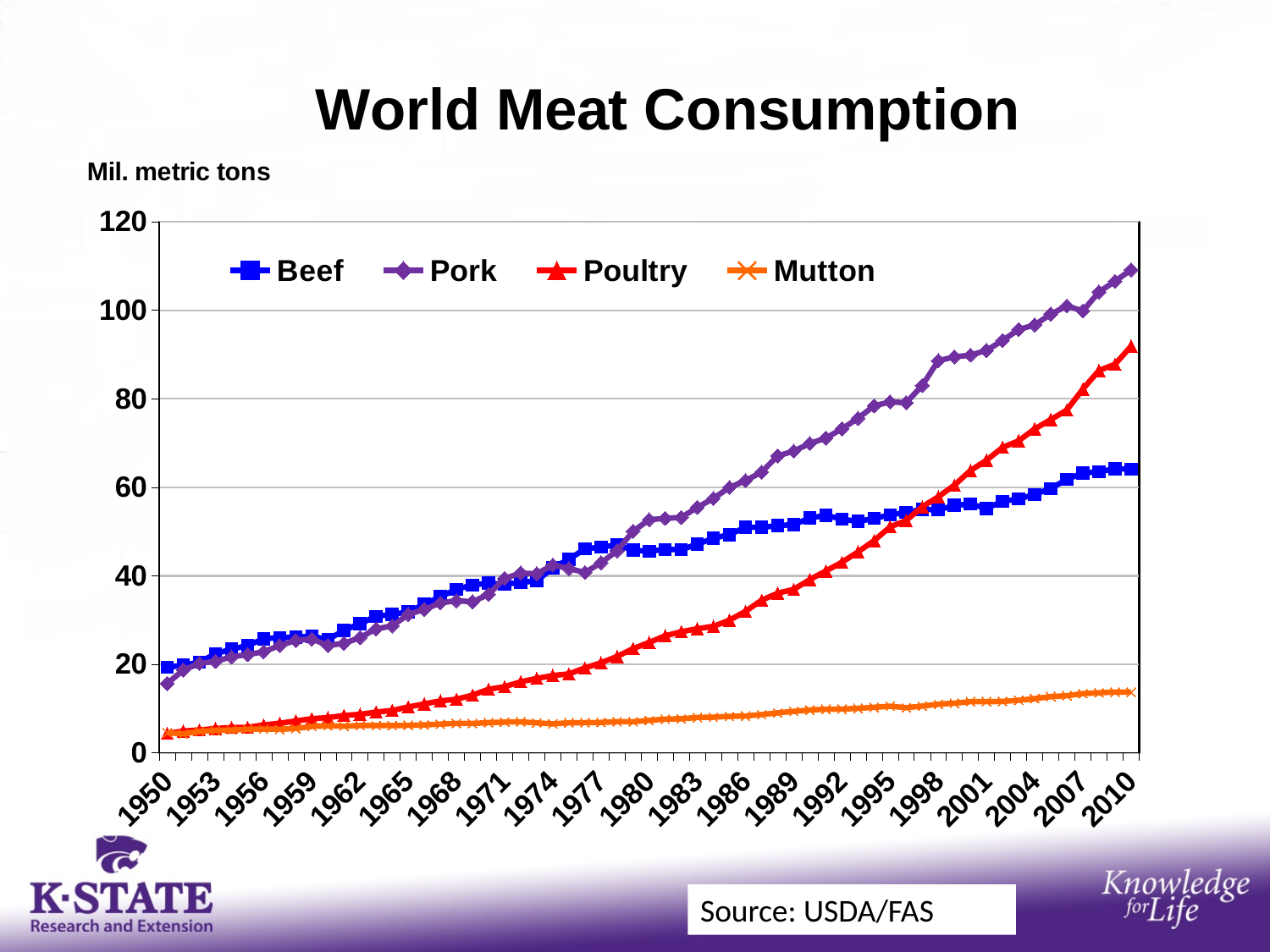
In 1980, which is larger, Beef or Poultry? Beef Does Pork consumption rise or fall from 1950 to 2010? rise What kind of chart is shown on the slide? line chart Is the value for Poultry in 1950 greater or less than 20? less Which series has the lowest value in 2010? Mutton Is the value for Poultry in 2010 greater or less than 80? greater What unit is given for the y axis? Mil. metric tons Which series has the highest value in 2010? Pork Is the value for Pork in 2010 greater or less than 100? greater How many series does the legend list? 4 Which series are listed in the legend? Beef, Pork, Poultry, Mutton